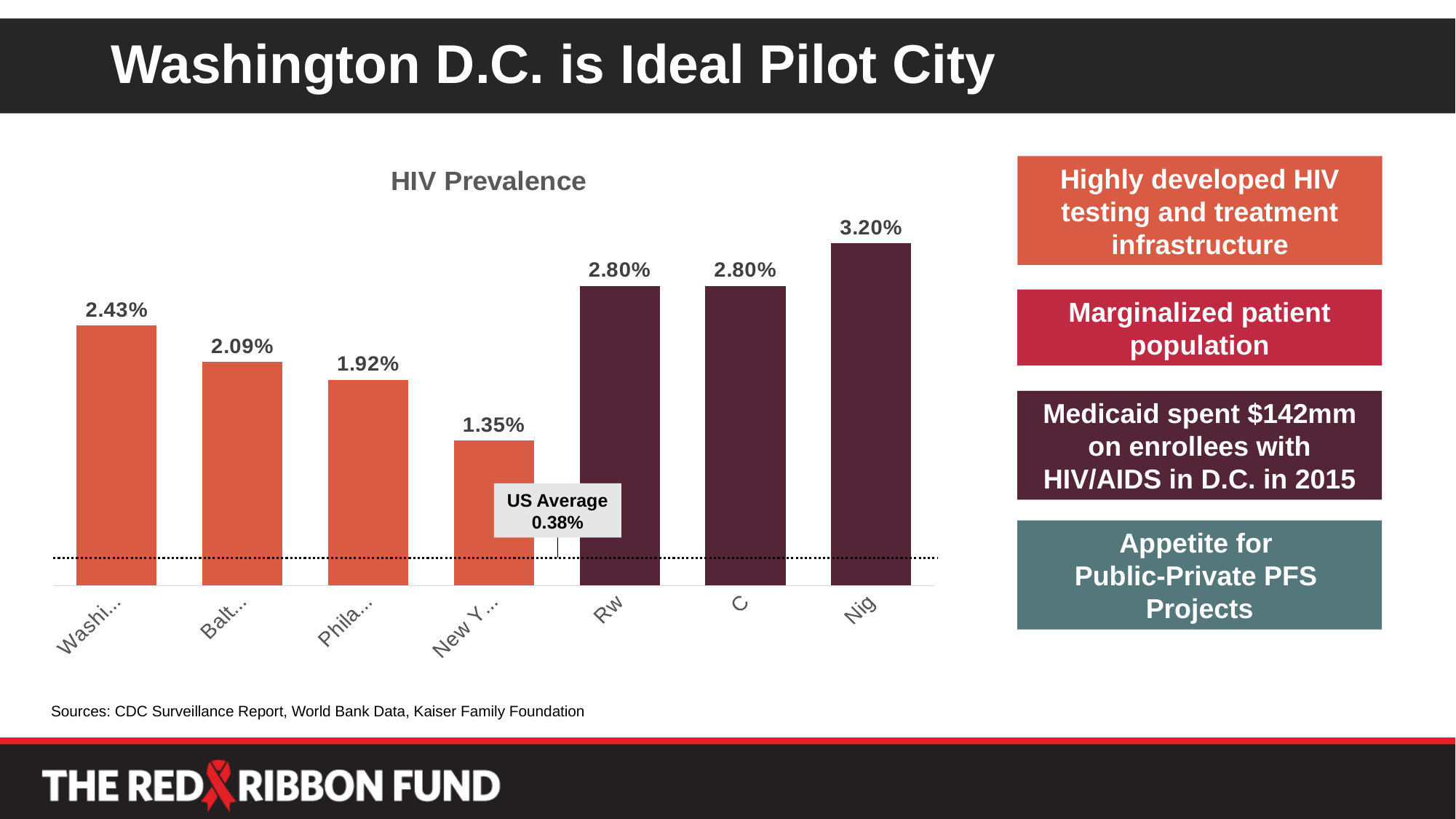
Which bar has the lowest value in the HIV Prevalence chart? New Y... (the fourth bar) What is the value shown for the first bar (labelled "Washi...") in the HIV Prevalence chart? 2.43% What kind of chart is shown under the title "HIV Prevalence"? Bar chart What is the difference between the value for "Nig" and the value for the first bar ("Washi...") in the HIV Prevalence chart? 0.77% How many bars are plotted in the HIV Prevalence chart? 7 What is the difference between the value for "Rw" and the value for "New Y..." in the HIV Prevalence chart? 1.45% In the HIV Prevalence chart, which is larger: the value for "Balt..." or the value for "Phila..."? Balt... What US Average value is marked by the dotted line in the HIV Prevalence chart? 0.38% How many bars in the HIV Prevalence chart are coloured dark maroon rather than orange? 3 What is the title of the chart on the slide? HIV Prevalence Which bar has the highest value in the HIV Prevalence chart? Nig What is the value shown for the bar labelled "Nig" in the HIV Prevalence chart? 3.20%